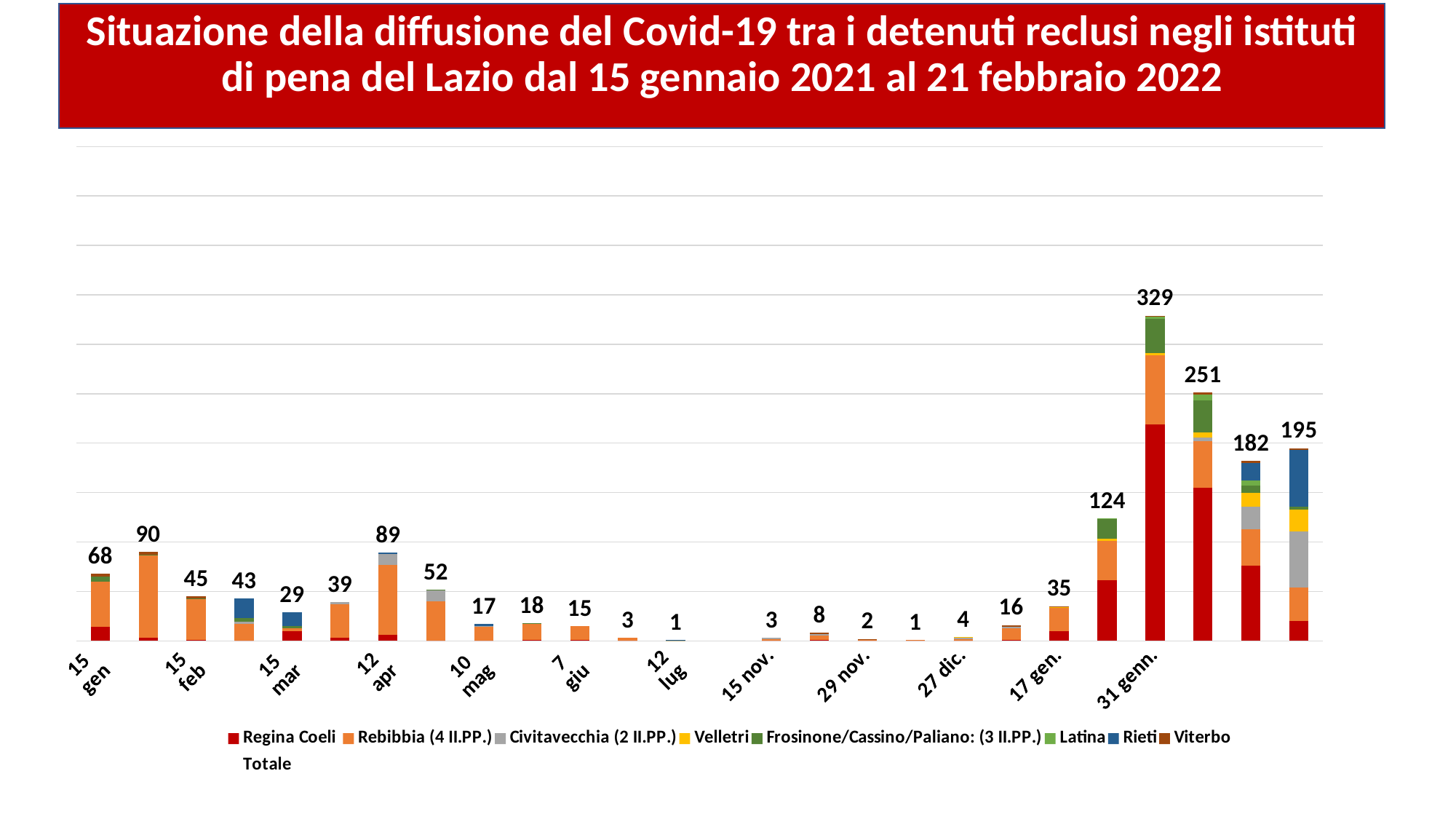
What is the difference between the total for 31 genn. (329) and the next bar (251)? 78 What is the difference between the totals for 15 feb and 15 mar? 16 What is the total number of cases shown for 12 apr? 89 What is the total number of cases shown for 17 gen.? 35 How many entries does the legend list? 9 What kind of chart is shown on the slide? Stacked bar chart Which labelled date has the highest total? 31 genn. Which has a larger total, 15 gen or 15 feb? 15 gen What is the total number of cases shown for 31 genn.? 329 What colour represents Regina Coeli in the chart? Red What is the total number of cases shown for 15 gen? 68 What is the total number of cases shown for 7 giu? 15